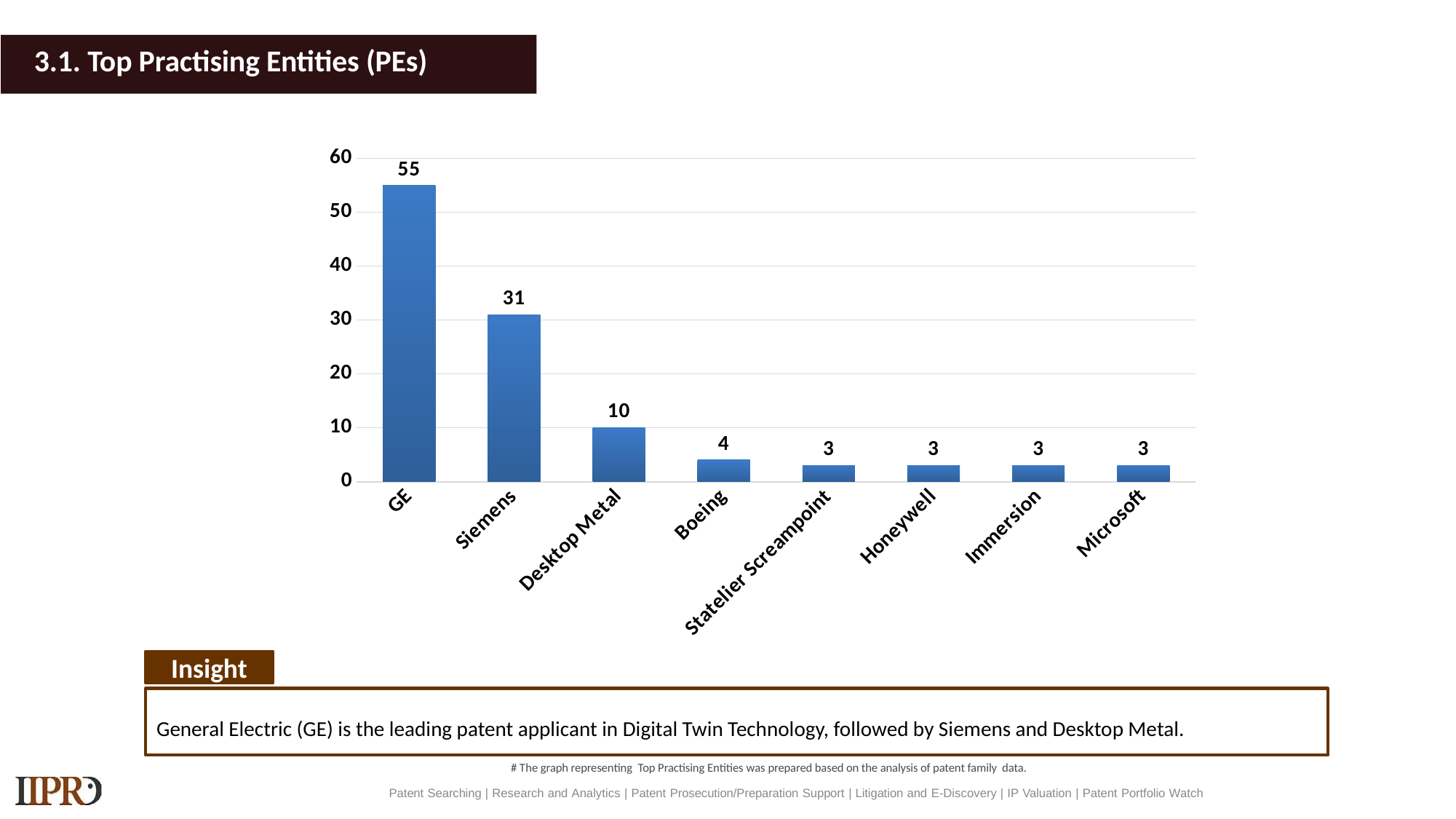
What kind of chart is shown on the slide? Bar chart What is the value for Honeywell? 3 What is the value for Siemens? 31 Which entity has the highest value? GE What is the value for Boeing? 4 What is the difference between the values for Siemens and Desktop Metal? 21 Do the values rise or fall from left to right along the x axis? Fall What is the value for GE? 55 How many entities are shown on the chart? 8 What is the value for Desktop Metal? 10 What is the difference between the values for GE and Siemens? 24 Which is larger, the value for Desktop Metal or the value for Boeing? Desktop Metal